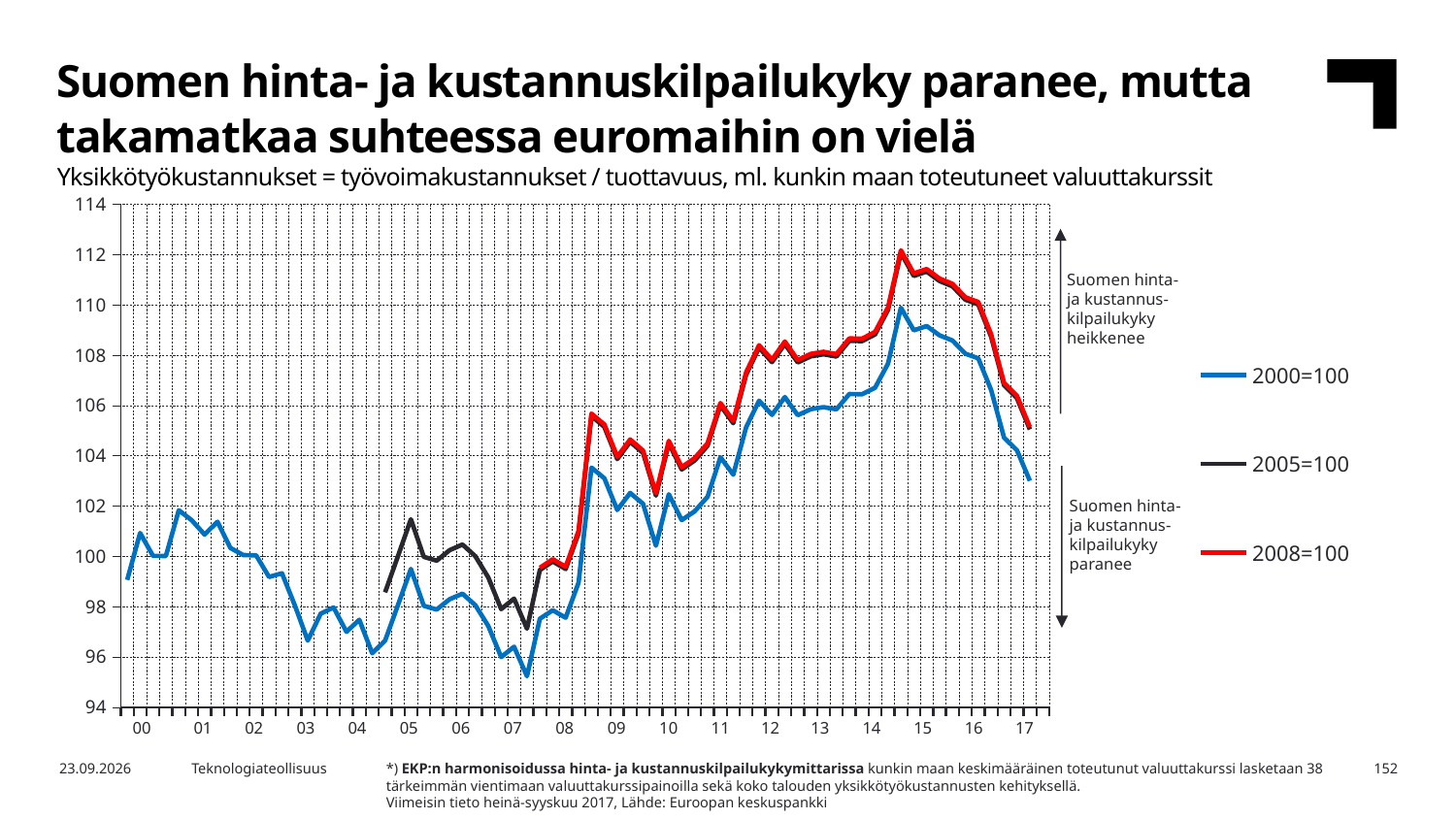
How many series does the legend list? 3 What colour is the 2008=100 series drawn in? red Is the peak value of the 2000=100 series around 2014-15 greater or less than 108? greater Is the lowest value of the 2000=100 series, around 2007, greater or less than 96? less Is the peak value of the 2008=100 series around 2015 greater or less than 110? greater What are the three series named in the legend? 2000=100, 2005=100, 2008=100 How many year labels are shown on the x axis? 18 At the end of the chart in 2017, which series is higher, 2008=100 or 2000=100? 2008=100 What kind of chart is shown on the slide? line chart Does the 2008=100 series rise or fall between 2008 and 2015? rise Does the 2000=100 series rise or fall between 2015 and 2017? fall